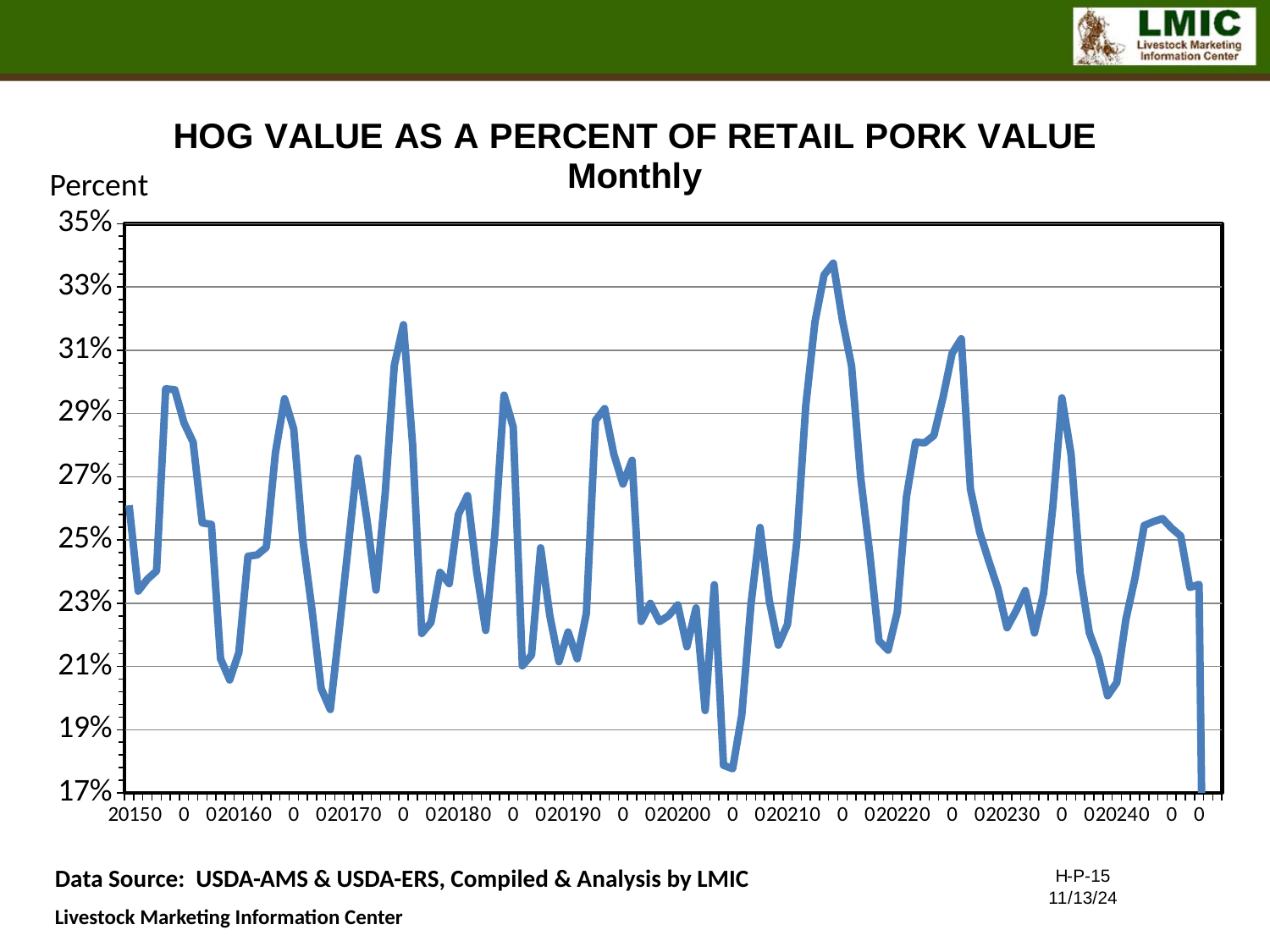
What kind of chart is shown on the slide? line chart Is the lowest point of the line on the chart (around 2020) greater or less than 19%? less Is the highest peak of the line on the chart greater or less than 33%? greater Is the peak of the line around 2017 greater or less than 31%? greater Which is higher on the chart: the peak around 2021 or the peak around 2017? the peak around 2021 What is the title of the chart? HOG VALUE AS A PERCENT OF RETAIL PORK VALUE Monthly What is the highest value shown on the vertical axis of the chart? 35%